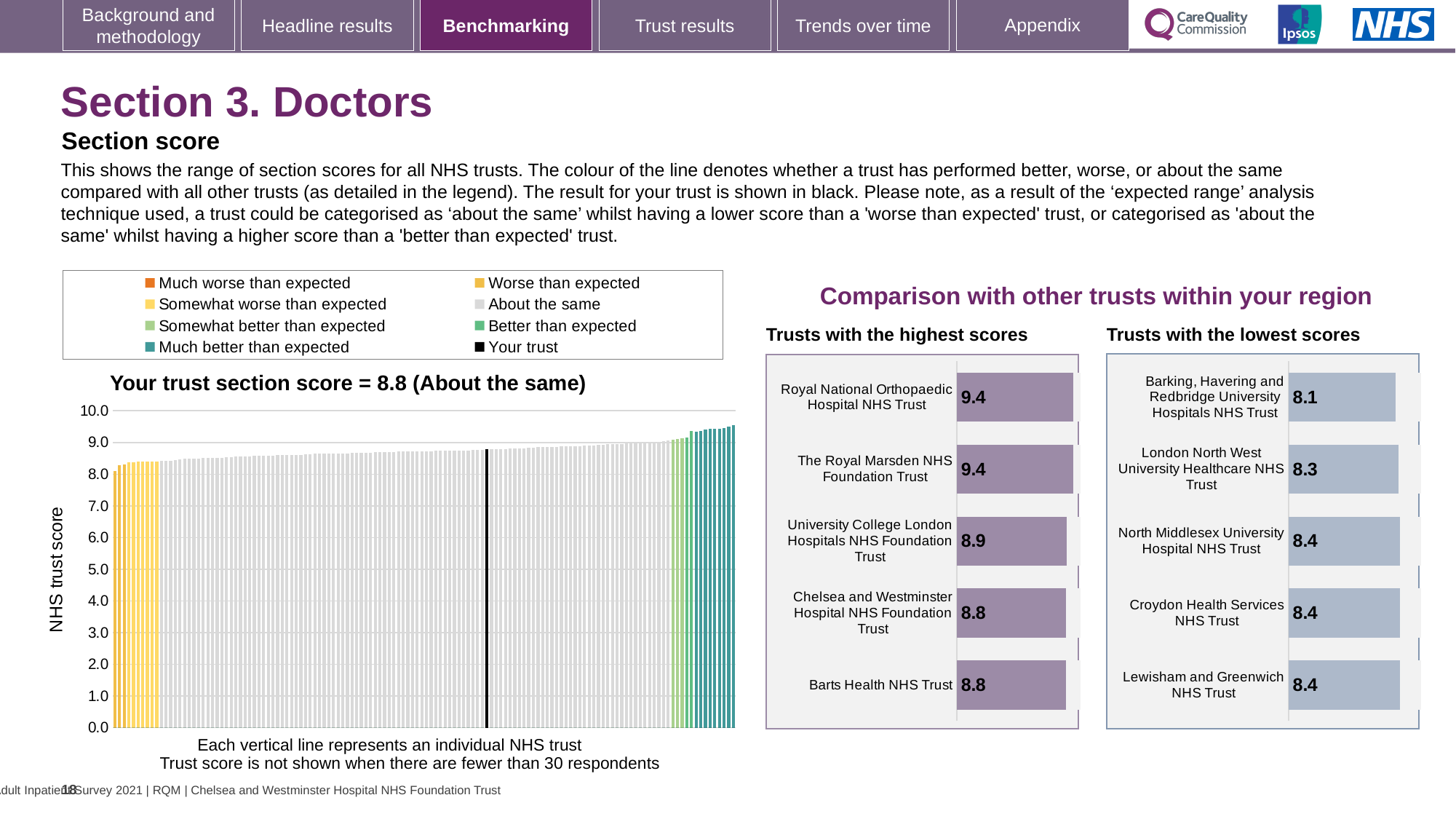
In the 'Trusts with the lowest scores' chart, which trust has the lowest score? Barking, Havering and Redbridge University Hospitals NHS Trust How many entries does the legend above the 'Your trust section score' chart list? 8 In the 'Your trust section score' chart, what category is your trust's score placed in? About the same In the 'Trusts with the lowest scores' chart, what is the score for London North West University Healthcare NHS Trust? 8.3 In the 'Trusts with the highest scores' chart, what is the score for University College London Hospitals NHS Foundation Trust? 8.9 What kind of chart is the 'Your trust section score' chart? bar chart In the 'Your trust section score' chart, what is the section score for your trust? 8.8 What is the y-axis label of the 'Your trust section score' chart? NHS trust score In the 'Trusts with the highest scores' chart, which has the higher score: The Royal Marsden NHS Foundation Trust or University College London Hospitals NHS Foundation Trust? The Royal Marsden NHS Foundation Trust In the 'Your trust section score' chart, do the trust scores rise or fall from left to right along the x axis? rise In the 'Trusts with the highest scores' chart, what is the difference between the scores of Royal National Orthopaedic Hospital NHS Trust and Barts Health NHS Trust? 0.6 In the 'Trusts with the highest scores' chart, how many trusts are shown? 5